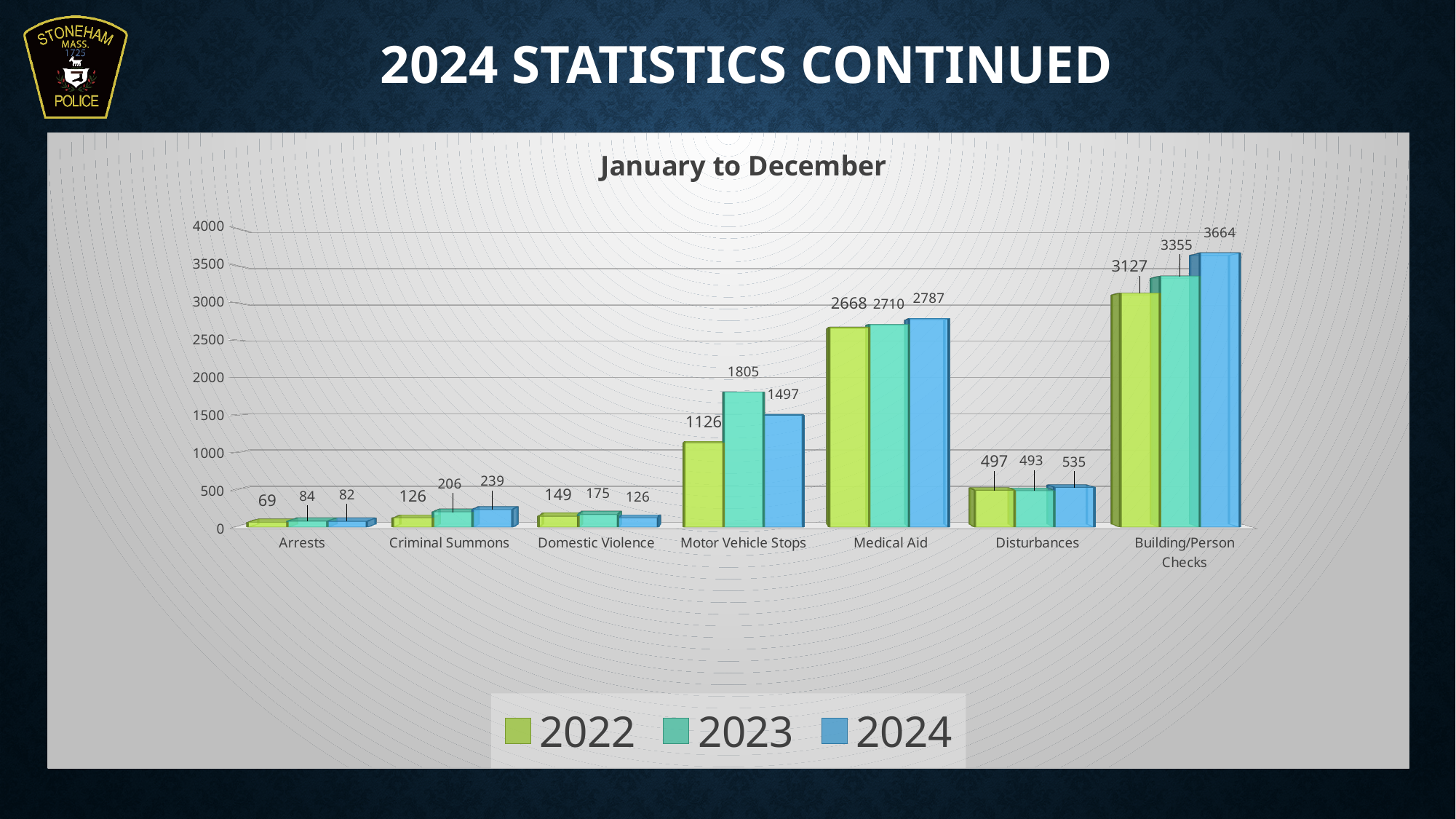
What kind of chart is shown on the slide? bar chart What is the value for Building/Person Checks in 2024? 3664 Which category has the lowest value in 2022? Arrests Which is larger for Criminal Summons: the 2022 value or the 2024 value? 2024 What is the value for Motor Vehicle Stops in 2023? 1805 What is the title of the chart? January to December How many series does the legend list? 3 What is the difference between the 2023 and 2024 values for Motor Vehicle Stops? 308 What is the value for Domestic Violence in 2022? 149 How many categories are shown on the x axis? 7 Which category has the highest value in 2024? Building/Person Checks Is the value for Medical Aid in 2024 greater or less than 2500? greater